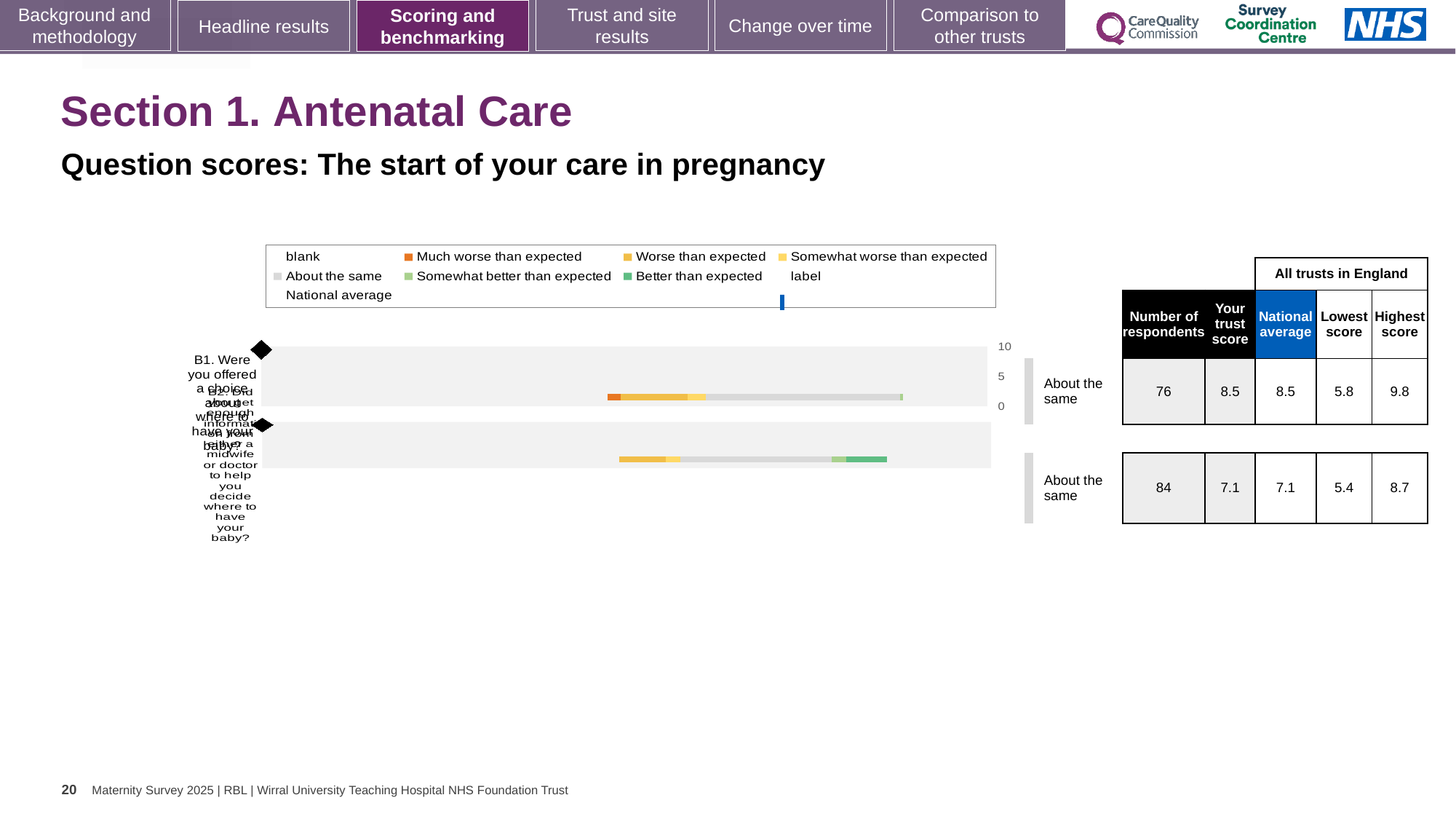
What is the difference between the highest and lowest scores for question B1? 4.0 What is the trust score for question B1? 8.5 What is the number of respondents for question B1? 76 How is the trust's result for question B2 rated compared with expectations? About the same Which question has the higher trust score, B1 or B2? B1 How many questions (categories) are plotted in the chart? 2 What is the national average for question B2? 7.1 Which question has more respondents, B1 or B2? B2 What colour does the legend use for 'Much worse than expected'? orange What is the highest score among all trusts in England for question B1? 9.8 What kind of chart is shown on the slide? bar chart What is the lowest score among all trusts in England for question B2? 5.4